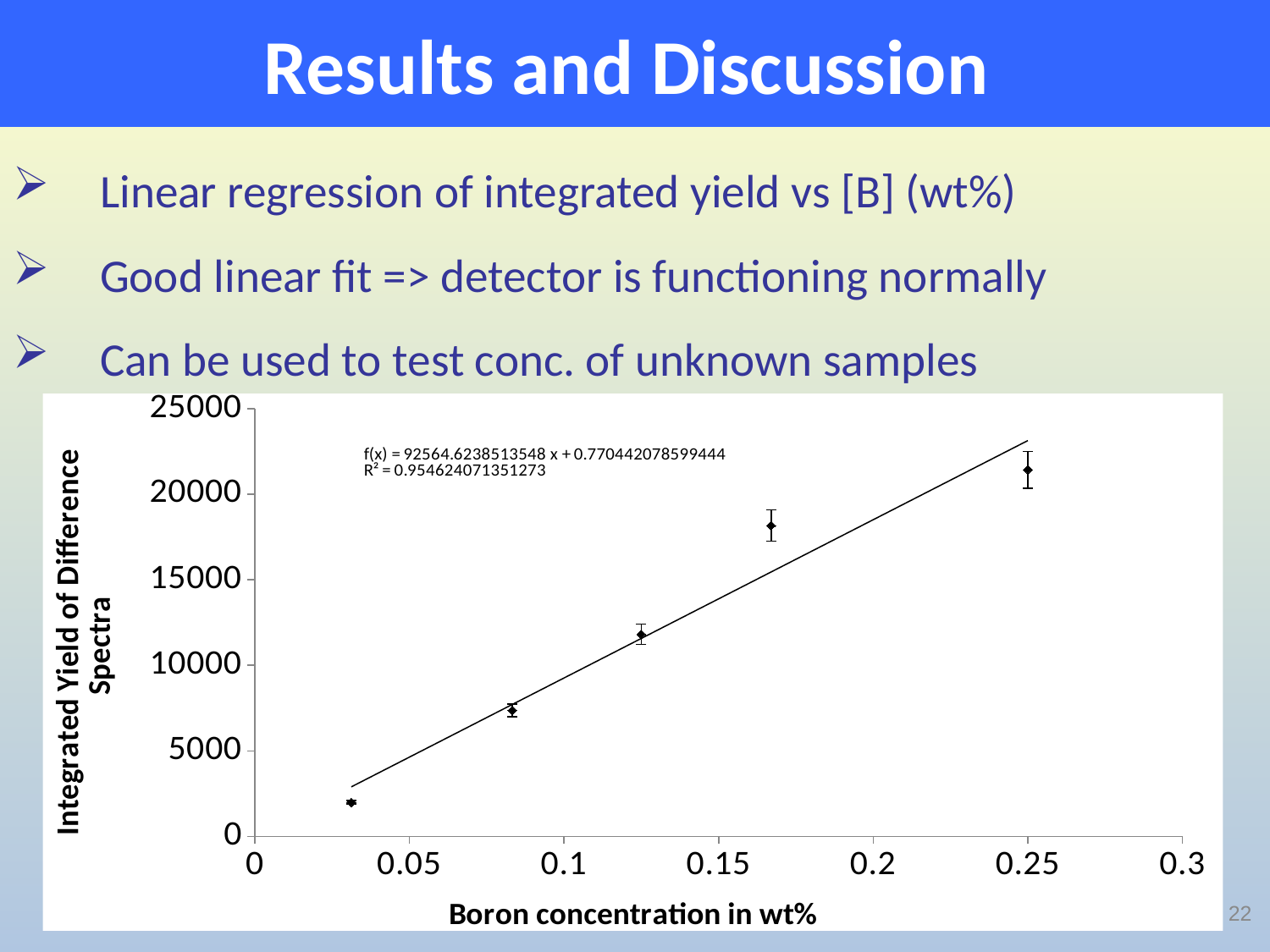
What is the title of the x axis of the chart? Boron concentration in wt% Do the integrated yield values rise or fall as boron concentration increases along the x axis? Rise What R² value is printed on the chart for the linear fit? 0.954624071351273 Is the integrated yield for the point at about 0.03 wt% boron greater or less than 5000? less Is the integrated yield for the point at about 0.167 wt% boron greater or less than 20000? less Is the integrated yield for the point at about 0.125 wt% boron greater or less than 10000? greater What kind of chart is shown on the slide? Scatter chart with a linear trendline Which plotted point has the highest integrated yield: the one at 0.25 wt% or the one at about 0.167 wt%? The one at 0.25 wt% How many data points are plotted on the chart? 5